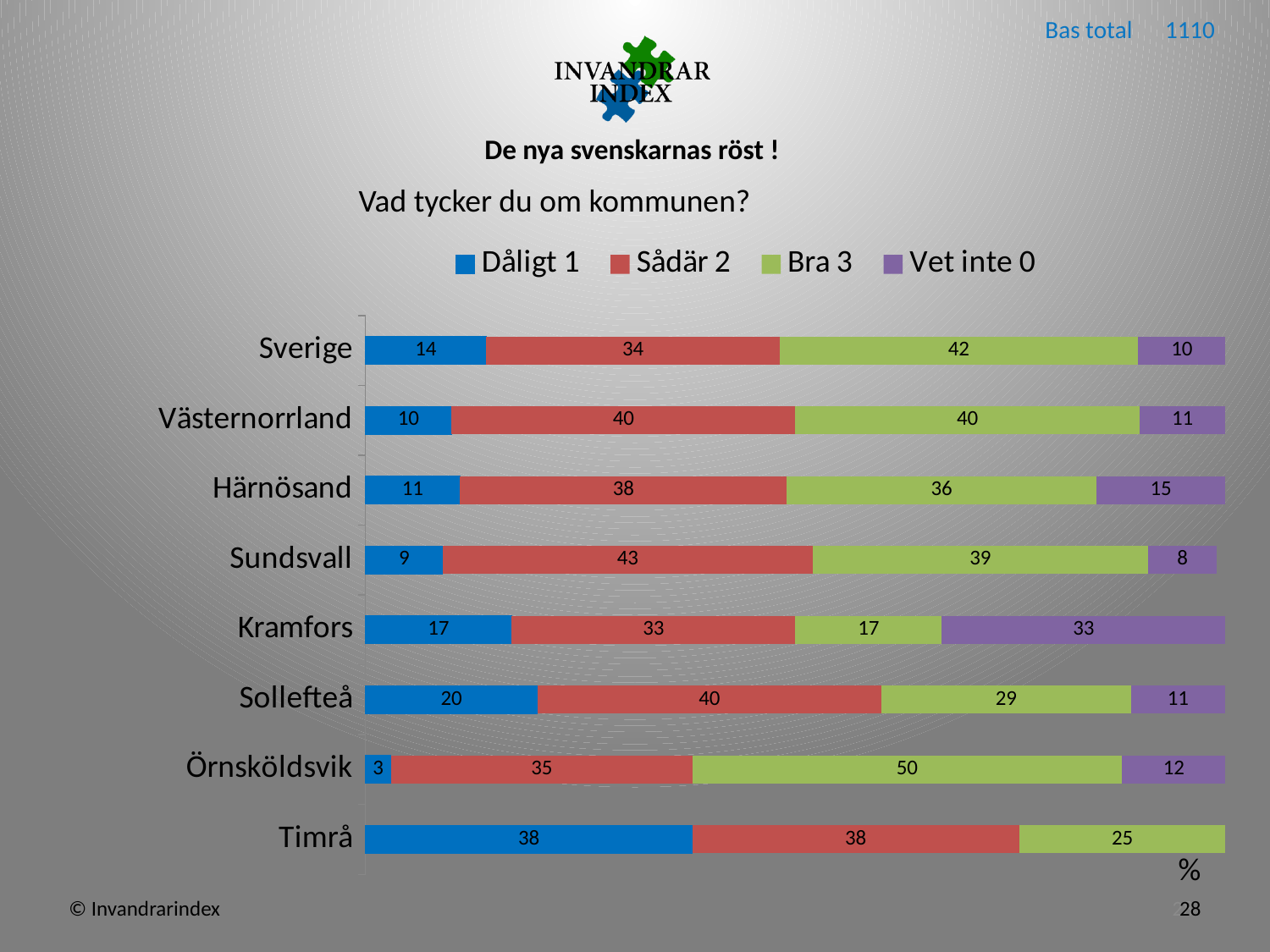
How many series does the legend list? 4 What is the value of Bra 3 for Örnsköldsvik? 50 Which category has the highest value for Vet inte 0? Kramfors Which category has the highest value for Bra 3? Örnsköldsvik What is the value of Vet inte 0 for Härnösand? 15 How many categories are shown on the chart? 8 Which has a larger Bra 3 value, Sverige or Härnösand? Sverige What is the difference between the Sådär 2 value for Sundsvall and the Sådär 2 value for Sverige? 9 What is the total of the stacked bar for Sverige? 100 What is the value of Dåligt 1 for Timrå? 38 Which category has the lowest value for Dåligt 1? Örnsköldsvik What kind of chart is shown on the slide? Stacked bar chart